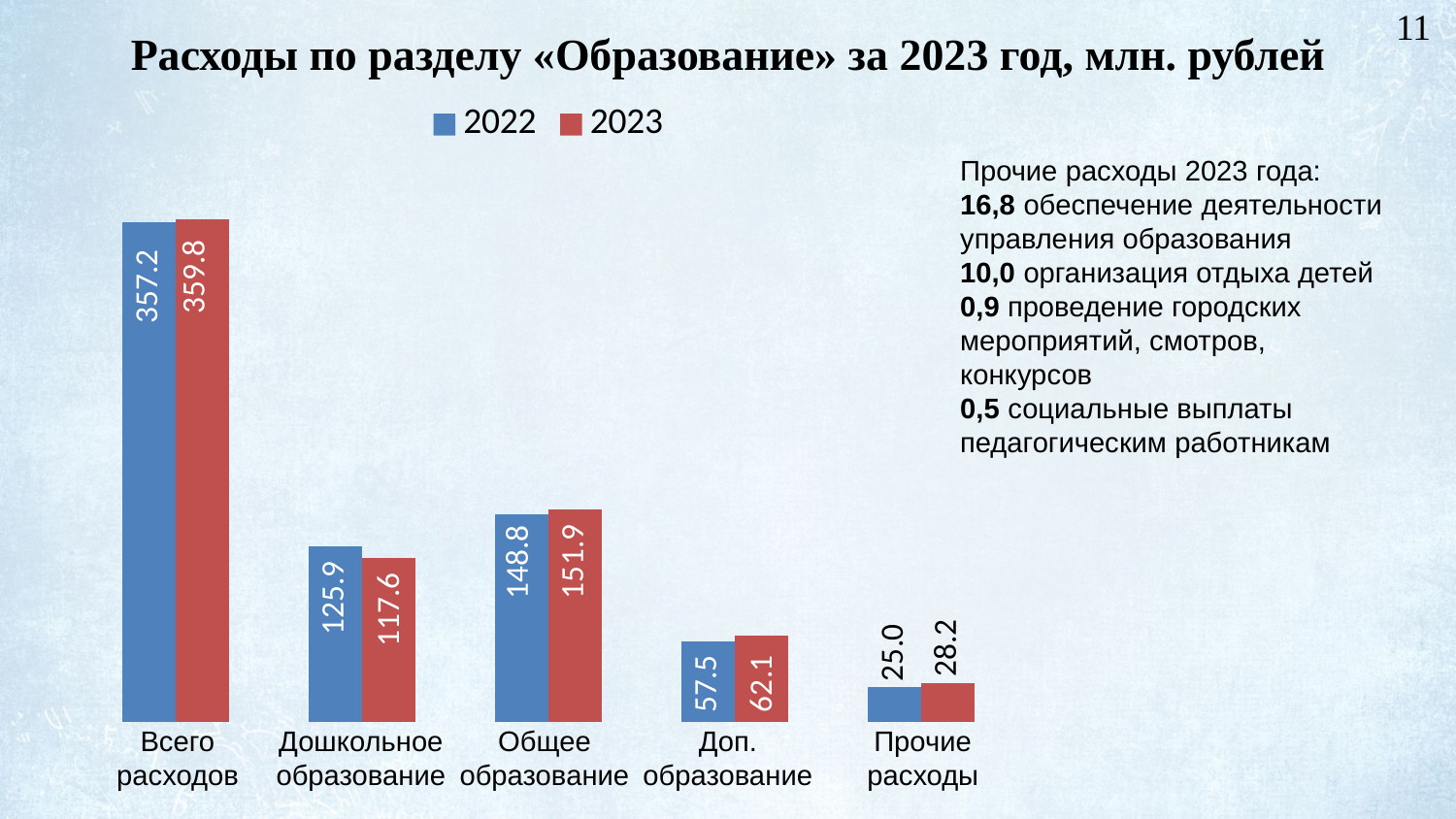
What kind of chart is shown on the slide? bar chart What is the difference between the 2022 and 2023 values for Дошкольное образование? 8.3 Which category has the highest 2023 value? Всего расходов What is the 2023 value for Общее образование? 151.9 What is the 2022 value for Дошкольное образование? 125.9 What is the difference between the 2023 and 2022 values for Доп. образование? 4.6 What is the 2022 value for Всего расходов? 357.2 What is the 2023 value for Прочие расходы? 28.2 Which is larger for Дошкольное образование, the 2022 value or the 2023 value? 2022 How many series does the legend list? 2 How many categories are shown on the x axis? 5 Which category has the lowest 2022 value? Прочие расходы